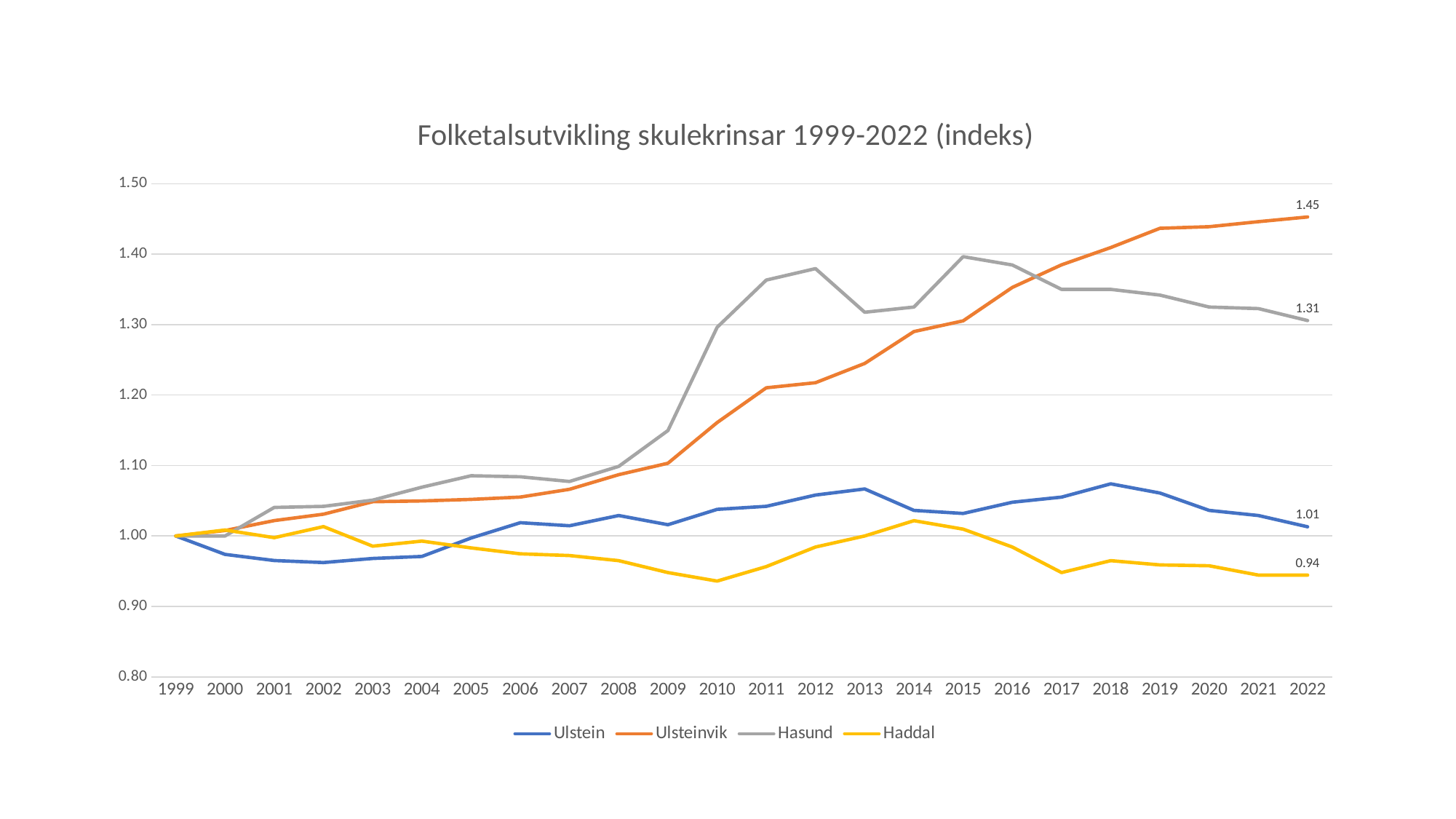
What is the value for Hasund in 2022? 1.31 Does the Ulsteinvik series generally rise or fall from 1999 to 2022? rise What is the difference between the 2022 values for Ulsteinvik and Hasund? 0.14 Which series has the lowest value in 2022? Haddal Which series has the highest value in 2022? Ulsteinvik What is the title of the chart? Folketalsutvikling skulekrinsar 1999-2022 (indeks) Is the value for Hasund in 2015 greater or less than 1.30? greater What is the value for Ulstein in 2022? 1.01 What kind of chart is shown on the slide? line chart How many series does the legend list? 4 What is the value for Ulsteinvik in 2022? 1.45 What is the value for Haddal in 2022? 0.94